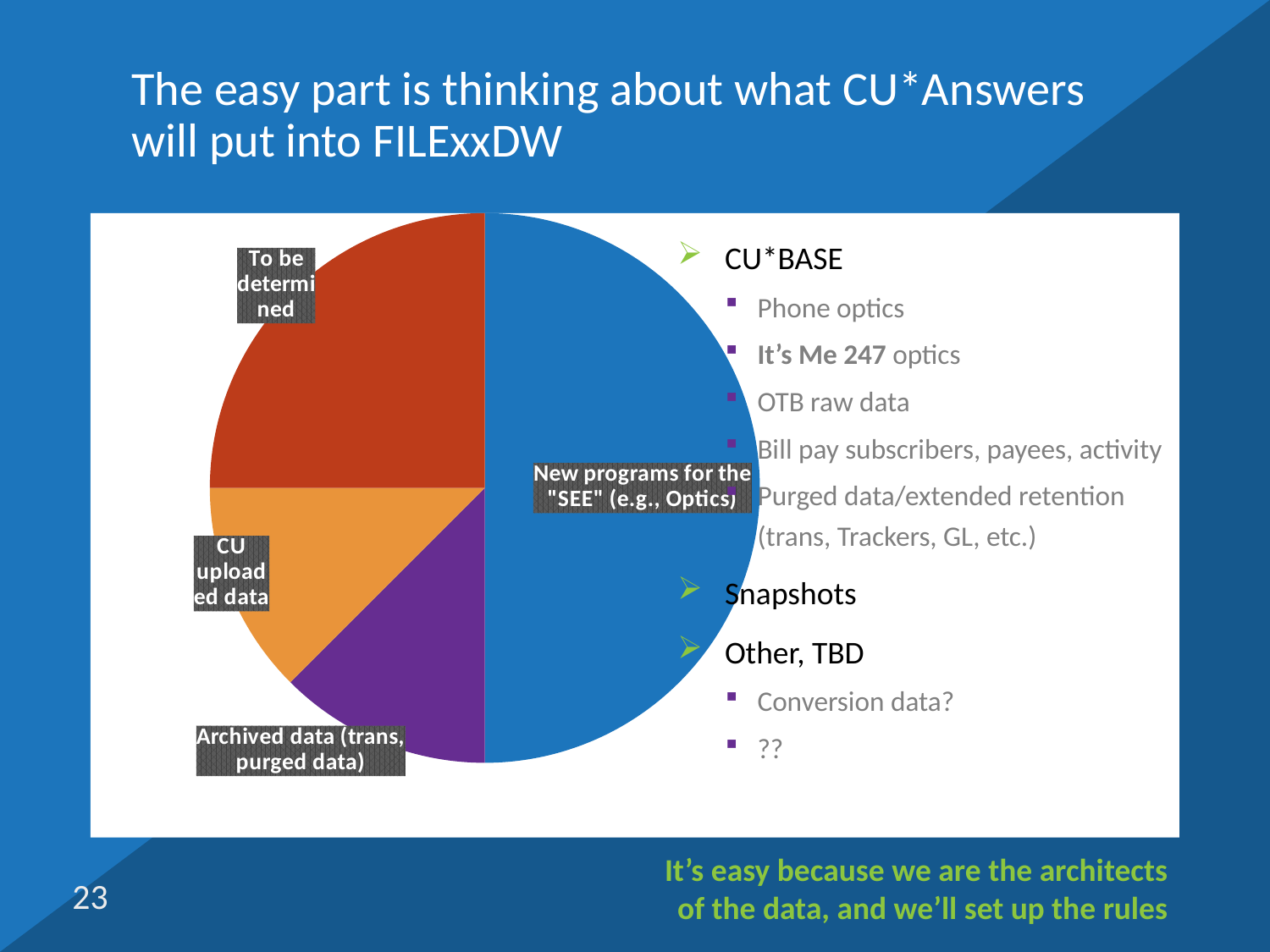
Which is larger in the pie chart: the "To be determined" slice or the "Archived data (trans, purged data)" slice? To be determined Which is larger in the pie chart: the "Archived data (trans, purged data)" slice or the "New programs for the "SEE" (e.g., Optics)" slice? New programs for the "SEE" (e.g., Optics) How many slices does the pie chart have? 4 What kind of chart is shown on the slide? pie chart Which is larger in the pie chart: the "New programs for the "SEE" (e.g., Optics)" slice or the "To be determined" slice? New programs for the "SEE" (e.g., Optics) Which slice of the pie chart is the largest? New programs for the "SEE" (e.g., Optics) What colour is the "To be determined" slice in the pie chart? red Which slice of the pie chart is coloured purple? Archived data (trans, purged data)